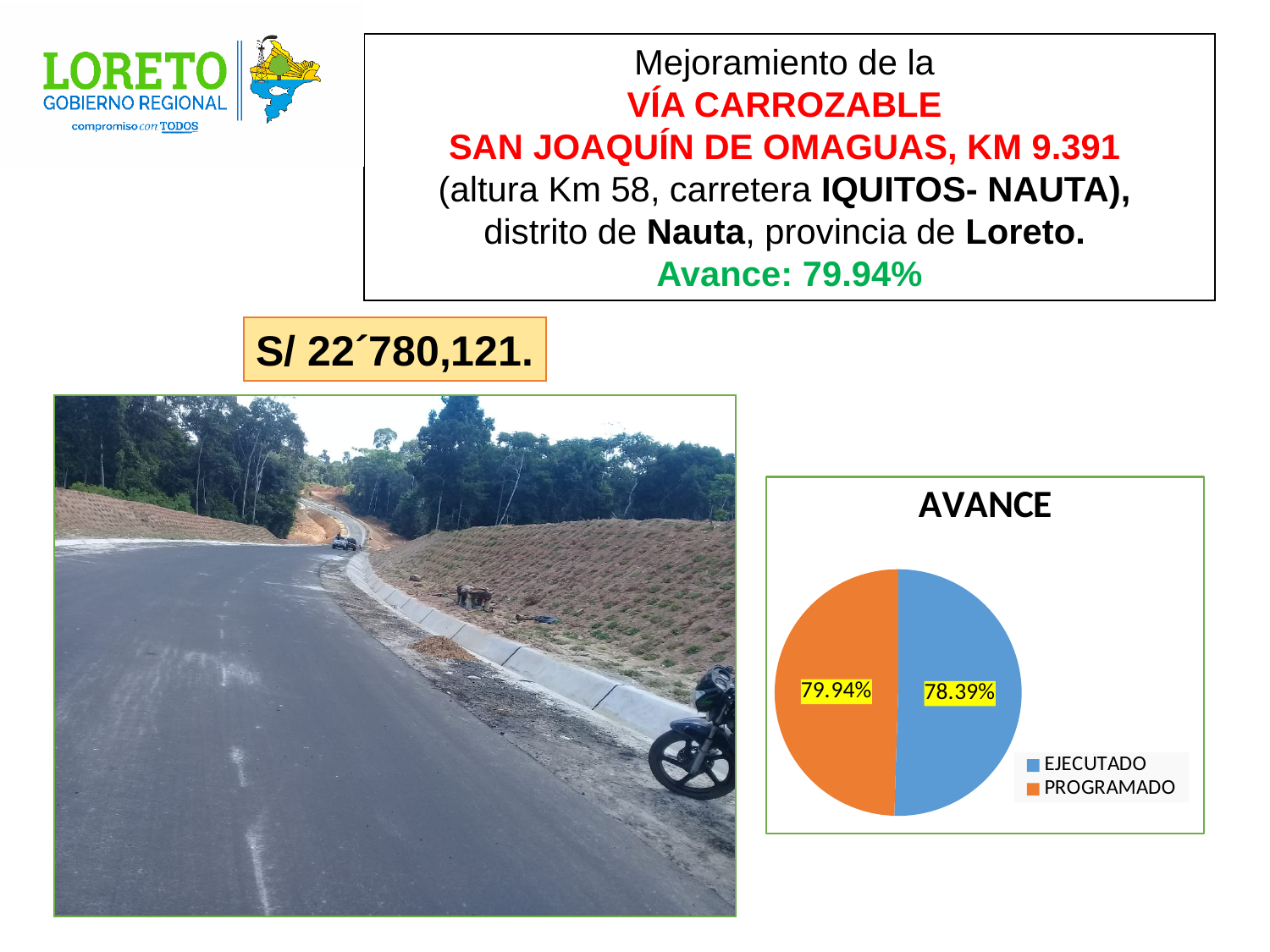
Which category has the lowest labelled value in the chart? EJECUTADO What is the title of the chart? AVANCE What value is labelled on the EJECUTADO slice? 78.39% What colour is the EJECUTADO slice in the chart? blue Which slice has the higher labelled value, EJECUTADO or PROGRAMADO? PROGRAMADO What value is labelled on the PROGRAMADO slice? 79.94% How many entries does the chart's legend list? 2 What is the difference between the labelled values for PROGRAMADO and EJECUTADO? 1.55% How many slices does the pie chart have? 2 Which category has the highest labelled value in the chart? PROGRAMADO What kind of chart is shown on the slide? pie chart